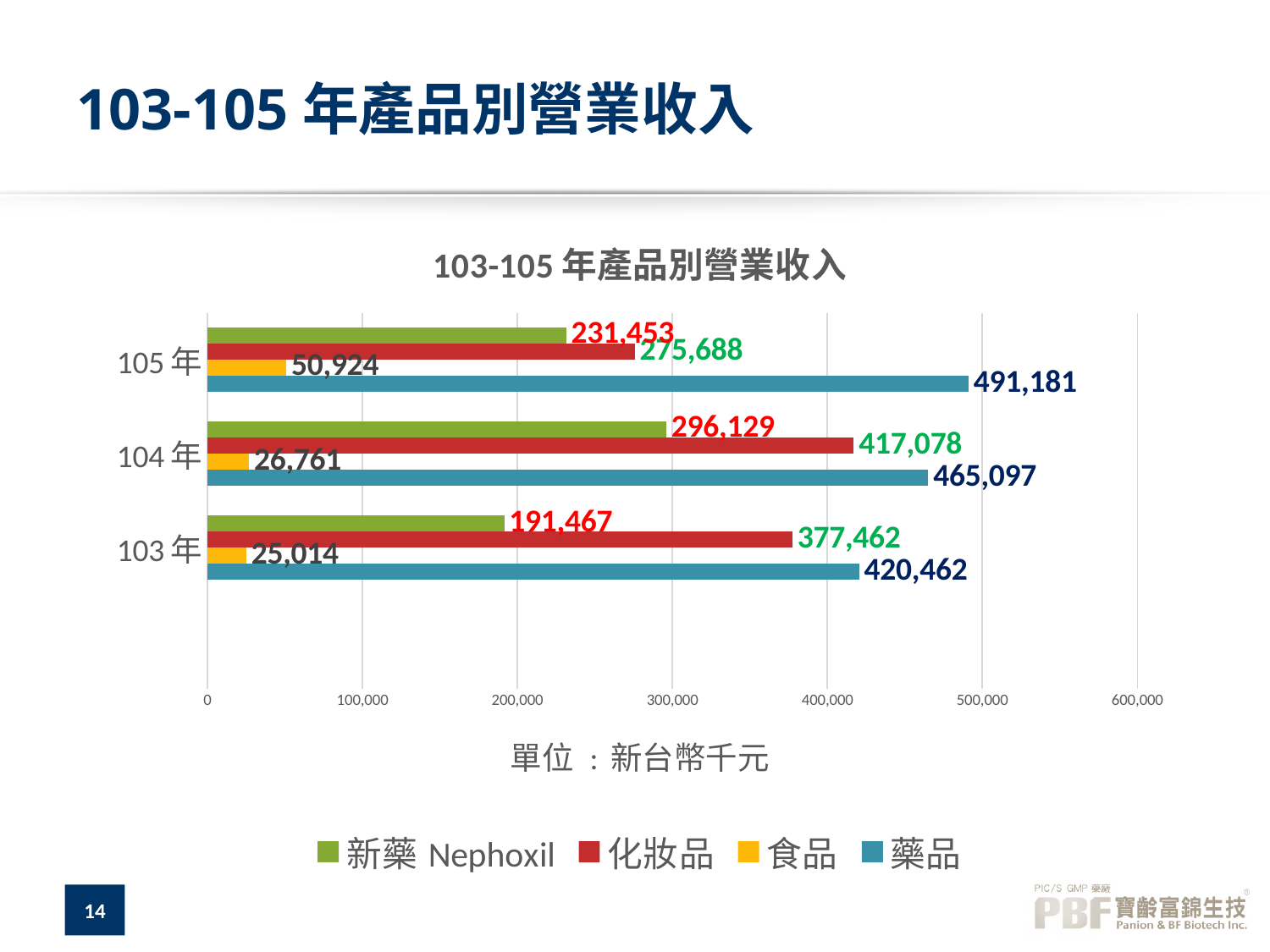
In which year is the 食品 value lowest? 103 年 Which is larger for 104 年: 新藥 Nephoxil or 化妝品? 化妝品 What kind of chart is shown on the slide? Bar chart In which year is the 藥品 value highest? 105 年 What is the value of 藥品 for 105 年? 491,181 How many years are shown on the chart? 3 What is the value of 食品 for 104 年? 26,761 How many series does the legend list? 4 What is the value of 新藥 Nephoxil for 103 年? 191,467 Is the value of 化妝品 for 103 年 greater or less than 300,000? greater What is the difference between the 藥品 values for 105 年 and 104 年? 26,084 What is the value of 化妝品 for 104 年? 417,078